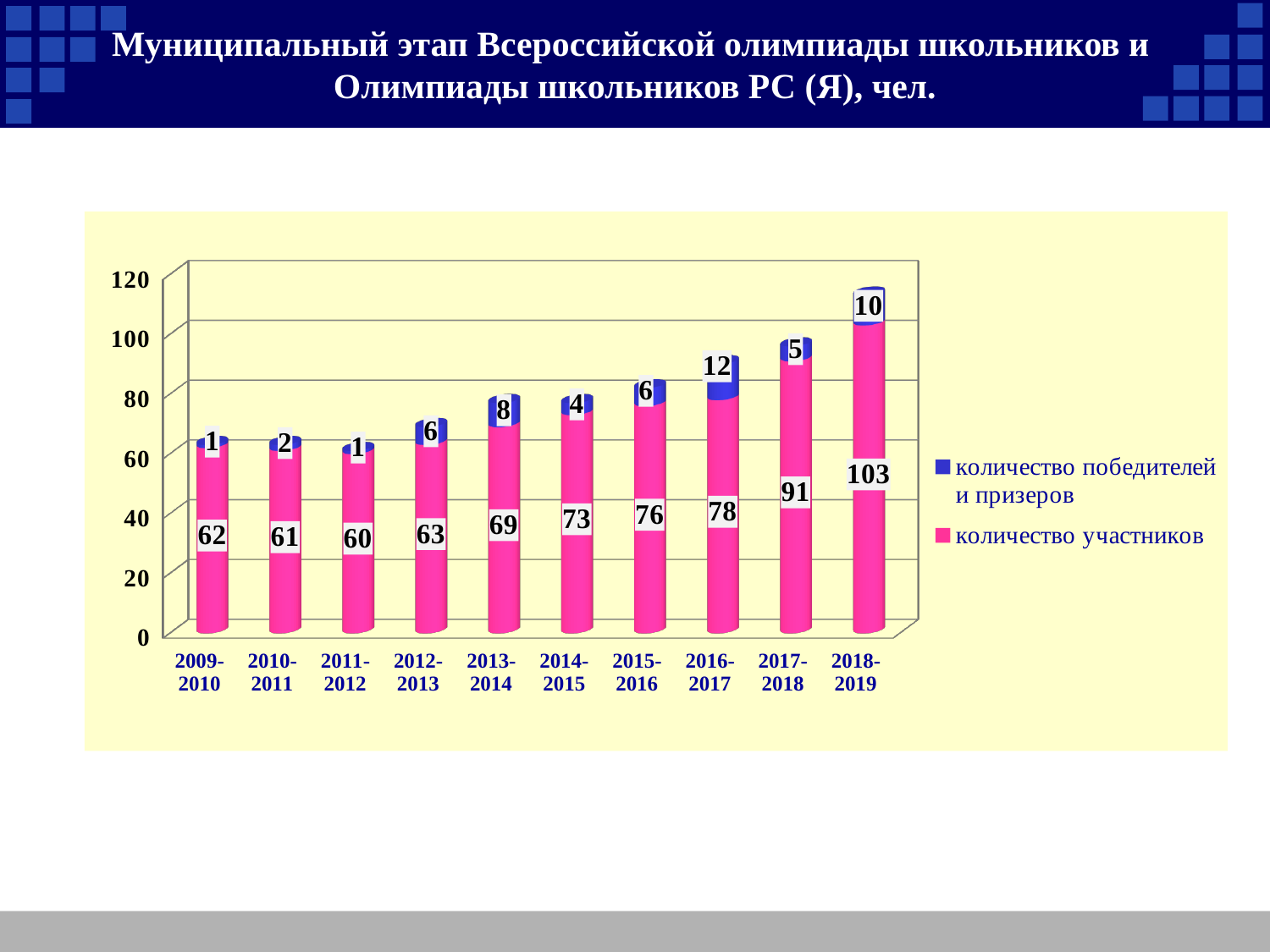
How many years are shown on the x axis? 10 What is the total of the stacked bar for 2018-2019? 113 How many series does the legend list? 2 What is the difference between количество участников in 2018-2019 and in 2017-2018? 12 What kind of chart is shown on the slide? Stacked bar chart Which year has the highest value for количество участников? 2018-2019 What is the value for количество участников in 2011-2012? 60 Which year has the highest value for количество победителей и призеров? 2016-2017 What is the value for количество участников in 2018-2019? 103 Which is larger: количество победителей и призеров in 2013-2014 or in 2014-2015? 2013-2014 Which year has the lowest value for количество участников? 2011-2012 What is the value for количество победителей и призеров in 2016-2017? 12